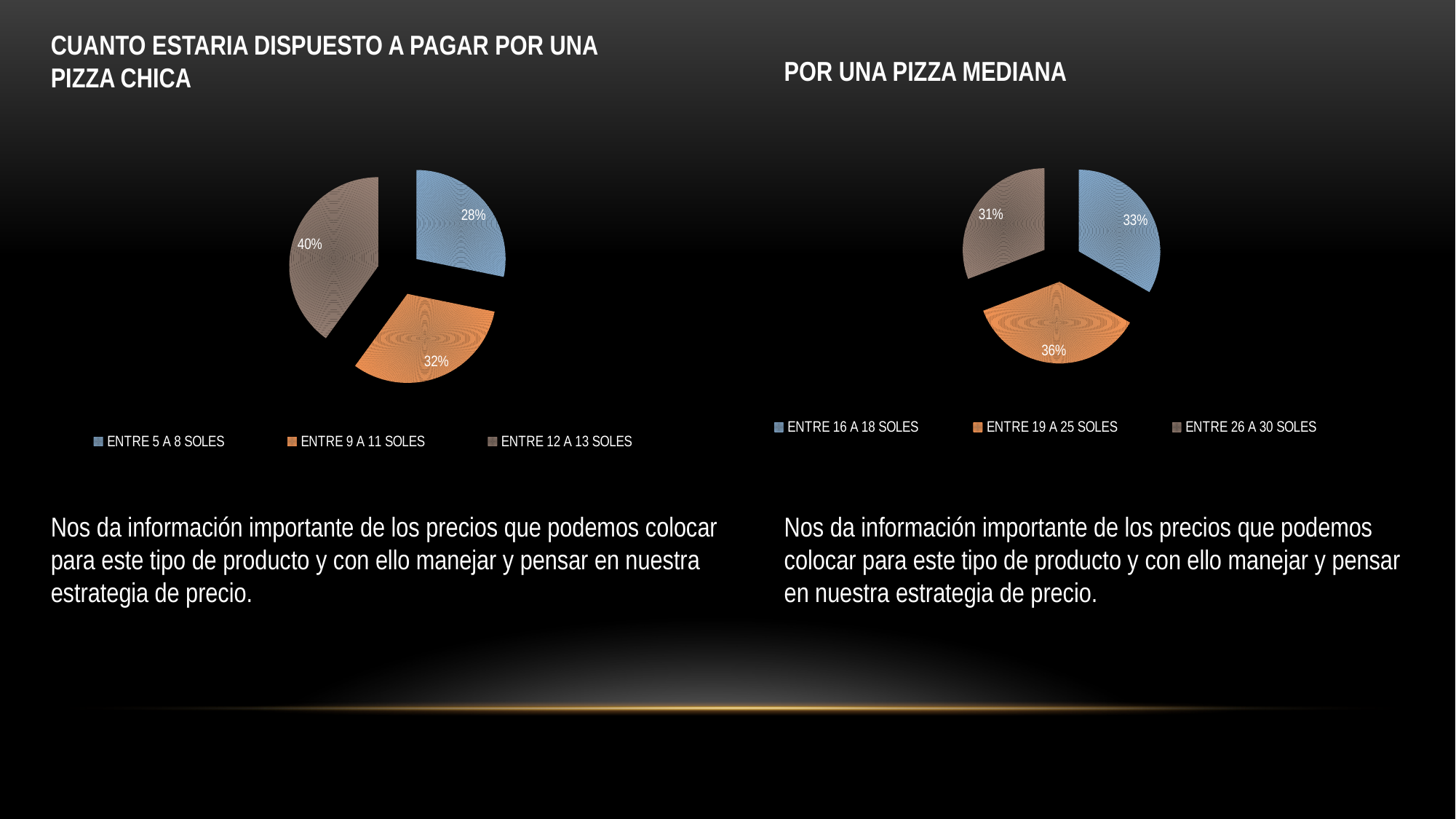
In the left chart (pizza chica), what share is labelled for ENTRE 5 A 8 SOLES? 28% In the right chart (pizza mediana), what share is labelled for ENTRE 19 A 25 SOLES? 36% In the left chart (pizza chica), which category has the smallest slice? ENTRE 5 A 8 SOLES In the left chart (pizza chica), which colour represents ENTRE 9 A 11 SOLES? Orange In the left chart (pizza chica), what share is labelled for ENTRE 12 A 13 SOLES? 40% In the right chart (pizza mediana), which is larger: ENTRE 16 A 18 SOLES or ENTRE 26 A 30 SOLES? ENTRE 16 A 18 SOLES How many slices does the right chart (pizza mediana) have? 3 What type of chart is the left chart (pizza chica)? Pie chart In the right chart (pizza mediana), what share is labelled for ENTRE 26 A 30 SOLES? 31% In the right chart (pizza mediana), which category has the largest slice? ENTRE 19 A 25 SOLES In the left chart (pizza chica), what is the difference in percentage points between ENTRE 12 A 13 SOLES and ENTRE 9 A 11 SOLES? 8 In the left chart (pizza chica), which category has the largest slice? ENTRE 12 A 13 SOLES